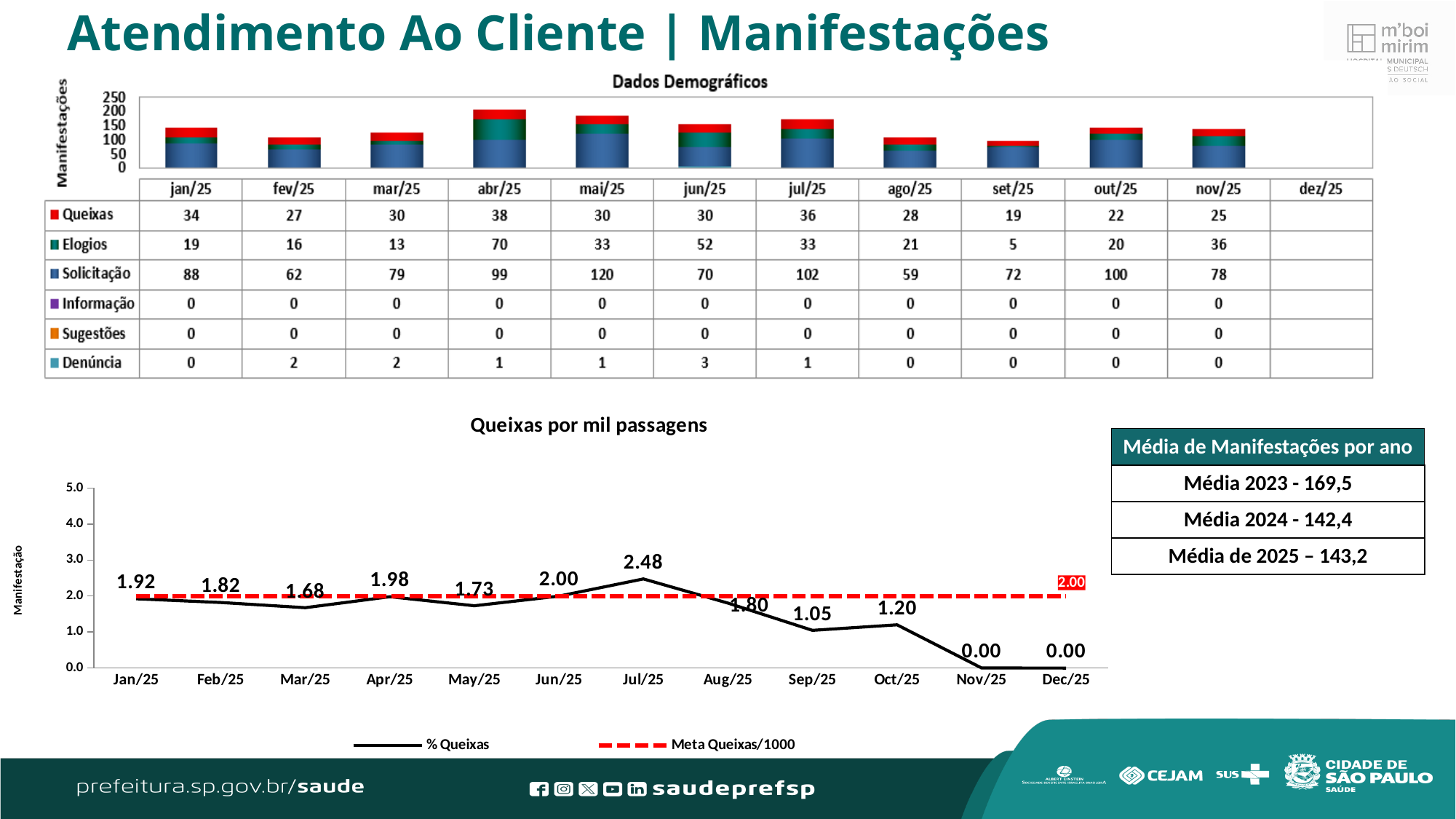
In the Dados Demográficos chart, what is the Queixas value for abr/25? 38 What kind of chart is the Queixas por mil passagens chart? line chart In the Queixas por mil passagens chart, is the % Queixas value for Sep/25 larger or smaller than the value for Oct/25? smaller In the Queixas por mil passagens chart, what is the % Queixas value for Jul/25? 2.48 In the Dados Demográficos chart, which month has the lowest Elogios value? set/25 In the Dados Demográficos chart, which month has the highest Solicitação value? mai/25 In the Queixas por mil passagens chart, what is the value of the Meta Queixas/1000 line? 2.00 In the Dados Demográficos chart, what is the total of the stacked bar for abr/25? 208 In the Dados Demográficos chart, how many series does the legend list? 6 In the Queixas por mil passagens chart, which month has the highest % Queixas value? Jul/25 In the Dados Demográficos chart, what is the difference between the Elogios values for abr/25 and mar/25? 57 In the Dados Demográficos chart, what is the Solicitação value for mai/25? 120